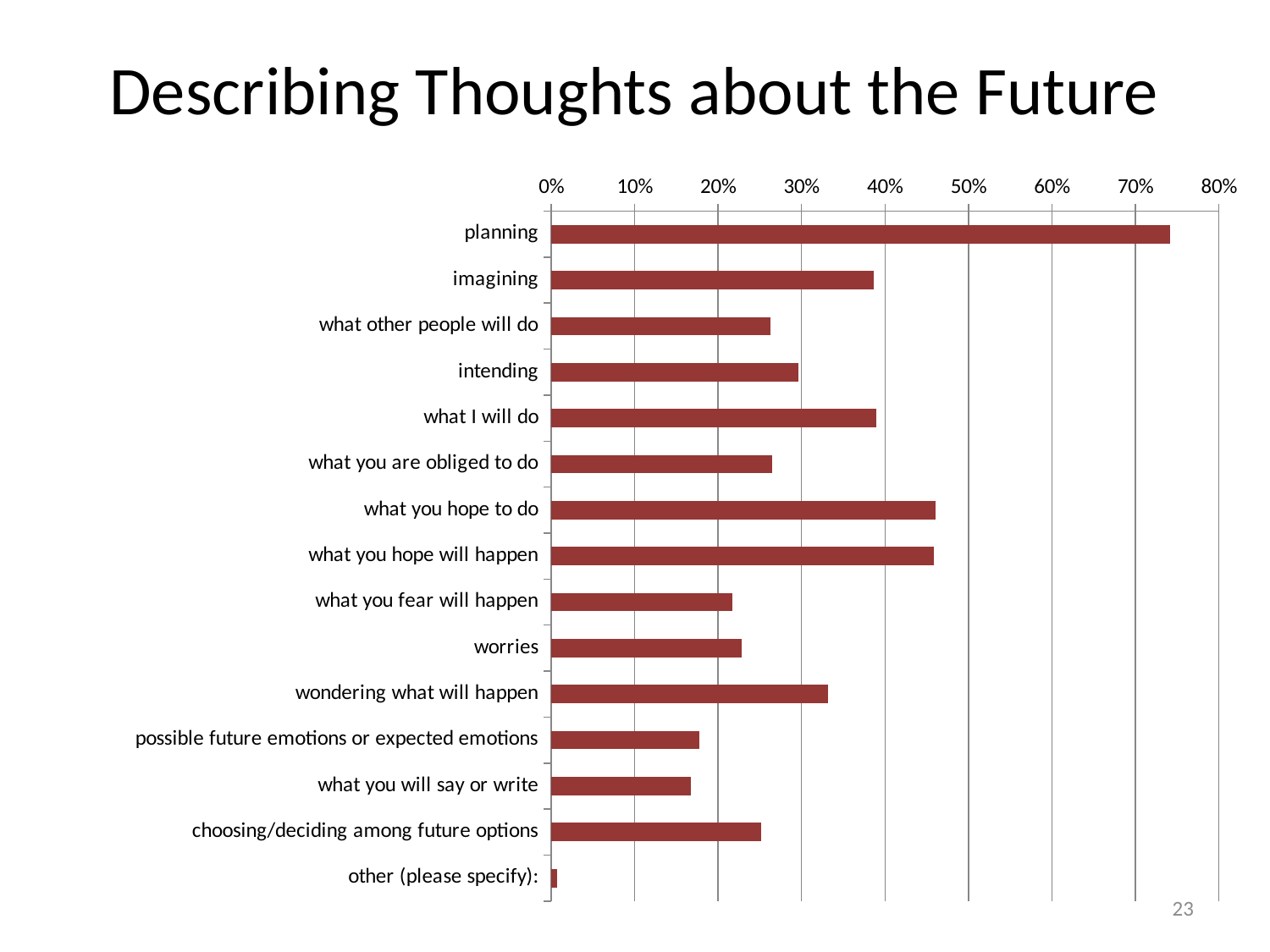
Is the value for planning greater or less than 70%? greater Is the value for worries greater or less than 30%? less What kind of chart is shown on the slide? bar chart What is the title of the slide? Describing Thoughts about the Future Is the value for what you will say or write greater or less than 20%? less How many categories are plotted in the chart? 15 Which category has the lowest value? other (please specify): Which category has the highest value? planning Which is larger, the value for what you fear will happen or the value for what you hope will happen? what you hope will happen Which is larger, the value for imagining or the value for intending? imagining